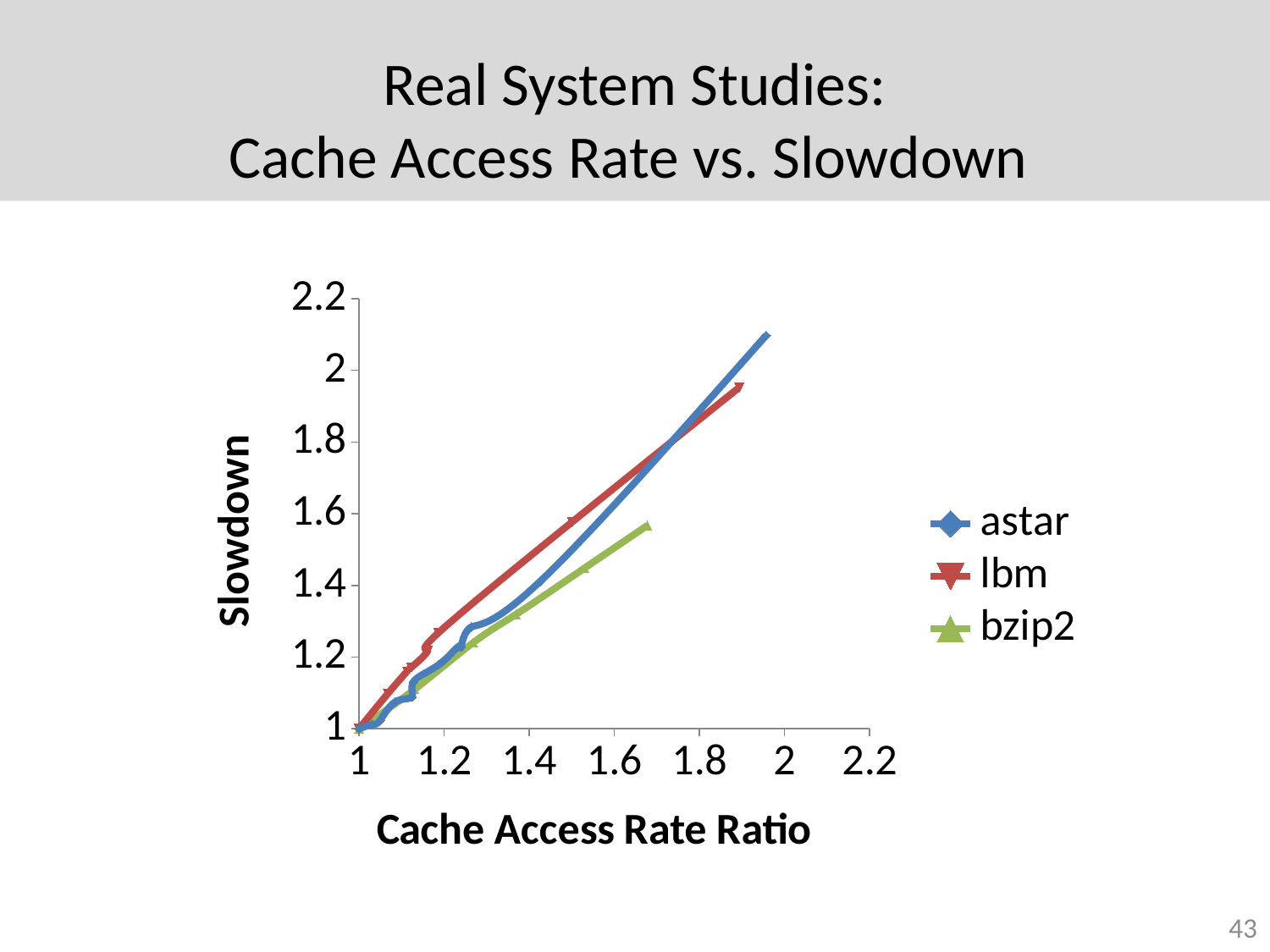
Is the highest slowdown reached by bzip2 greater or less than 1.8? less Which series reaches the lowest maximum slowdown? bzip2 At a cache access rate ratio of 1.4, is the slowdown for lbm greater or less than 1.4? greater At a cache access rate ratio of 1.4, which series has the higher slowdown, lbm or bzip2? lbm Which series are listed in the legend? astar, lbm, bzip2 Is the highest slowdown reached by astar greater or less than 2? greater Which series reaches the highest slowdown? astar What kind of chart is shown on the slide? line chart Does the slowdown rise or fall as the cache access rate ratio increases? rise How many series does the legend list? 3 What is the title of the y axis? Slowdown